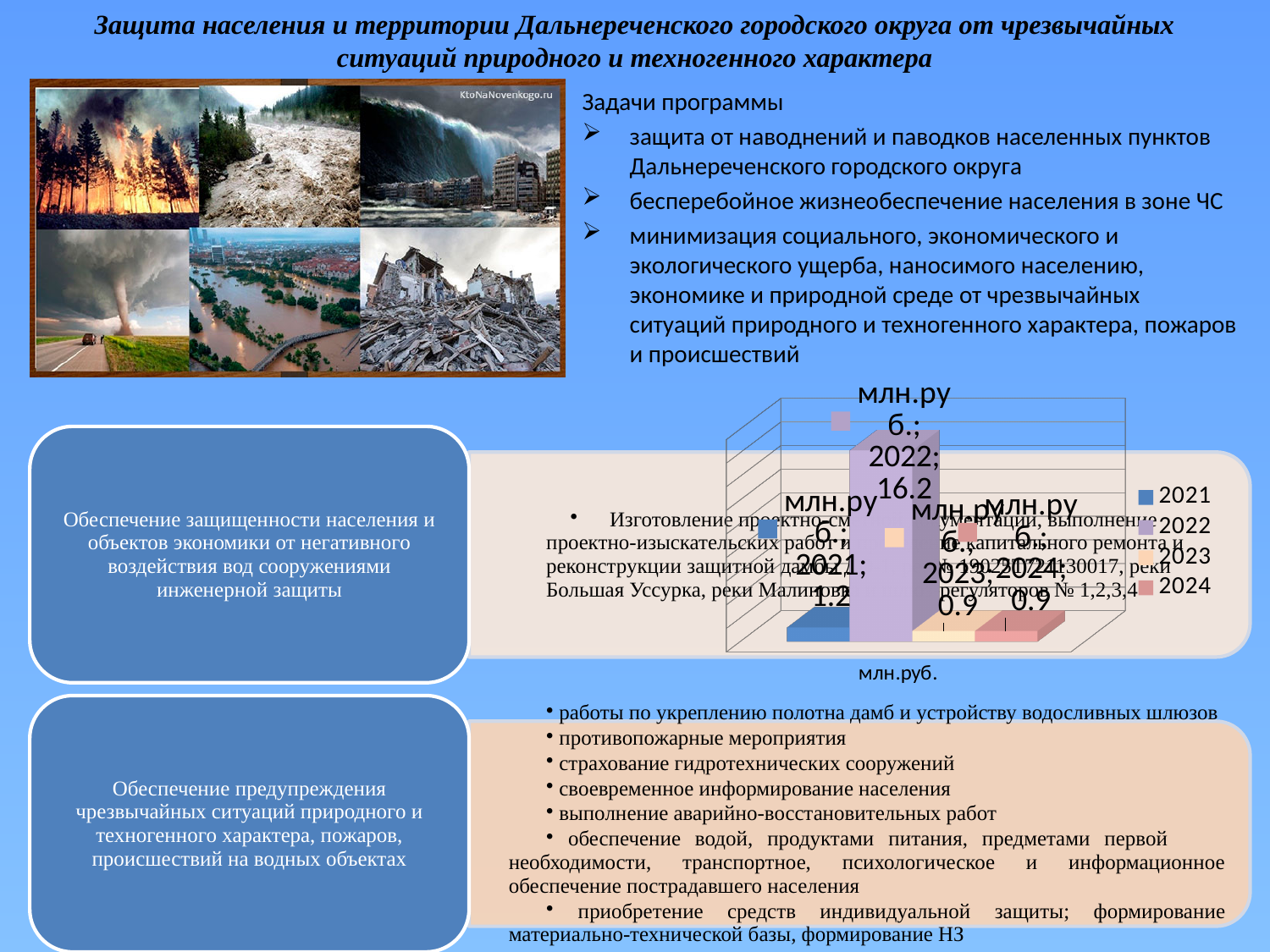
What is the value for 2023 in the chart? 0.9 What is the value for 2024 in the chart? 0.9 What kind of chart is shown on the slide? bar chart What unit is shown on the chart's category axis label? млн.руб. How many series does the chart legend list? 4 What is the value for 2022 in the chart? 16.2 What is the difference between the values for 2022 and 2021? 15 Which is larger, the value for 2021 or the value for 2024? 2021 What is the value for 2021 in the chart? 1.2 Which years are listed in the chart legend? 2021, 2022, 2023, 2024 Which year has the highest value in the chart? 2022 What is the difference between the values for 2021 and 2023? 0.3